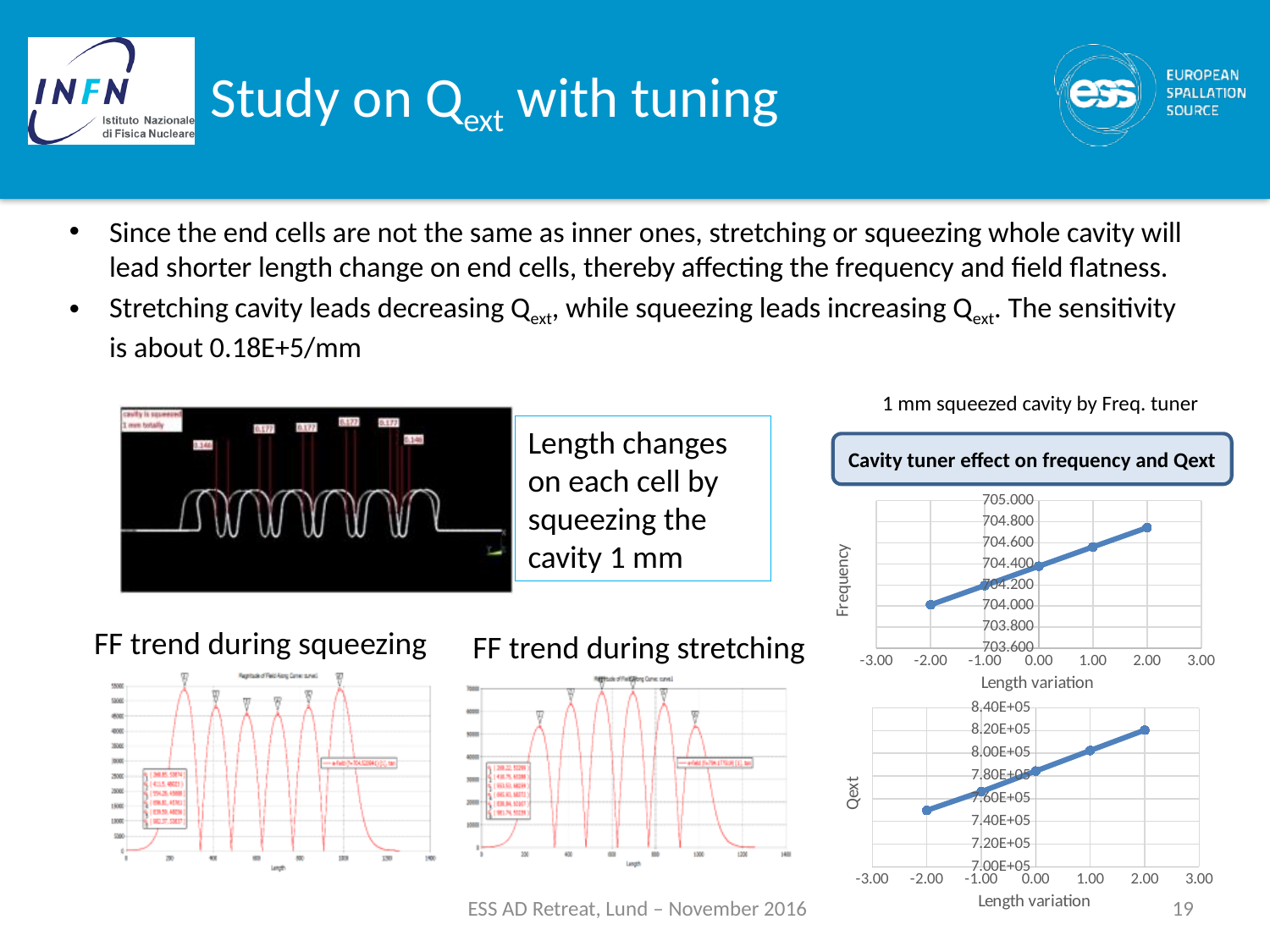
In the Qext chart (bottom right), is the value at Length variation -2.00 greater or less than 7.60E+05? less In the Qext chart (bottom right), is the value at Length variation 2.00 greater or less than 8.00E+05? greater How many data points are plotted in the Qext chart (bottom right)? 5 In the Frequency chart (top right), is the value at Length variation -2.00 greater or less than 704.200? less How many data points are plotted in the Frequency chart (top right)? 5 What kind of chart is the Qext vs Length variation chart (bottom right)? line chart What kind of chart is the Frequency vs Length variation chart (top right)? line chart In the Qext chart (bottom right), at which Length variation is Qext highest? 2.00 In the Frequency chart (top right), do the values rise or fall as Length variation increases? rise What is the title shown above the two charts on the right? Cavity tuner effect on frequency and Qext In the Qext chart (bottom right), do the values rise or fall as Length variation increases? rise